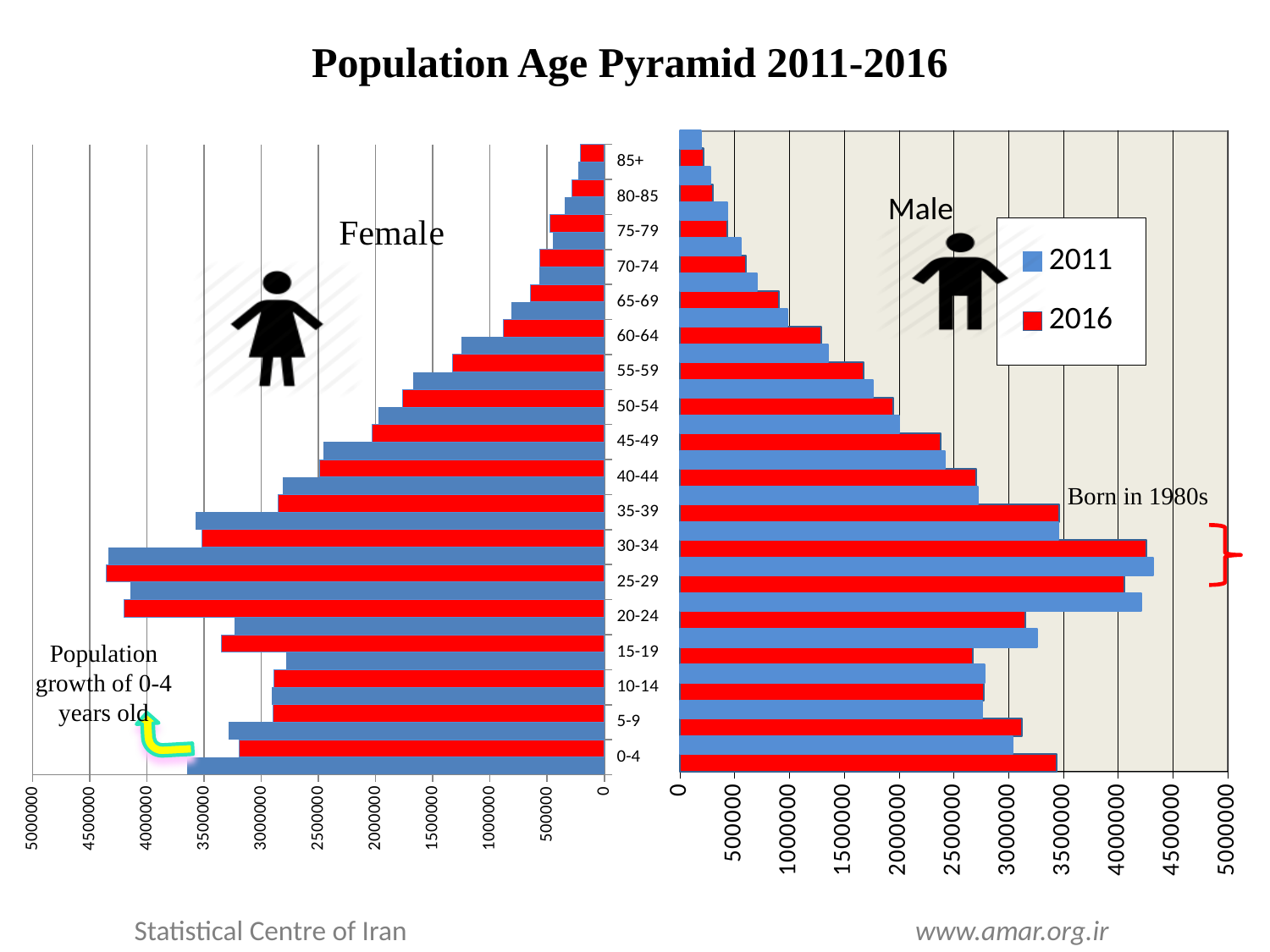
Which colour represents the 2016 series in the legend? red On the Male chart, for the 0-4 age group, which year has the larger value, 2011 or 2016? 2016 On the Male chart, is the 2016 value for the 60-64 age group greater or less than 1500000? less On the Male chart, is the 2016 value for the 0-4 age group greater or less than 3000000? greater What kind of chart is used for the Male population pyramid on the right? bar chart On the Male chart, for the 20-24 age group, which year has the larger value, 2011 or 2016? 2011 On the Male chart, which age group has the highest 2016 value? 30-34 How many age groups are shown on the Male chart? 18 How many series does the legend list? 2 On the Male chart, which age group has the lowest 2011 value? 85+ On the Male chart, is the 2011 value for the 20-24 age group greater or less than 4000000? greater